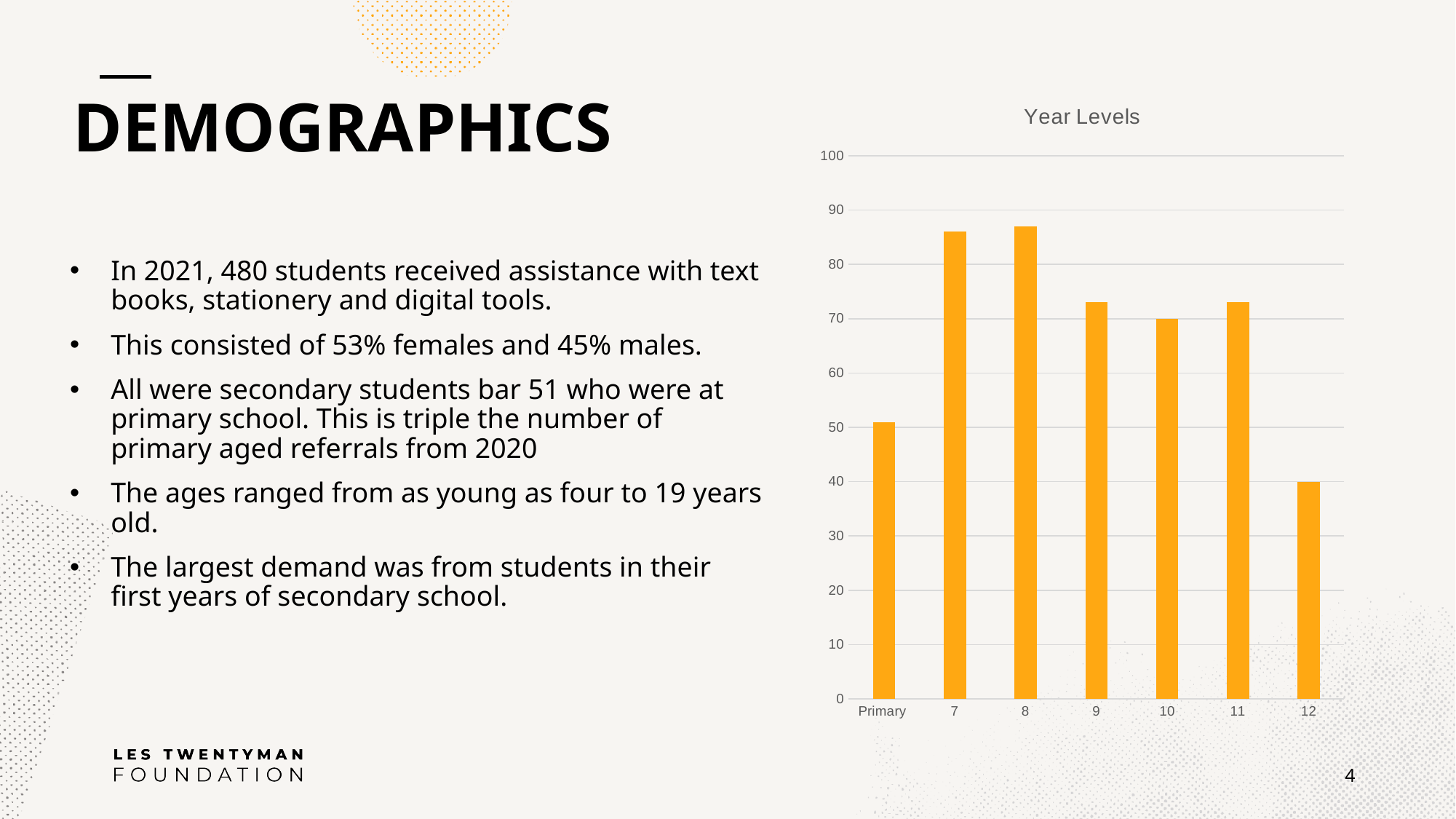
What kind of chart is shown on the slide? bar chart Is the value for year 12 greater or less than 50? less Which has the larger value, year 12 or Primary? Primary Is the value for year 8 greater or less than 80? greater Is the value for year 7 greater or less than 80? greater Which year level has the lowest bar in the chart? 12 What colour are the bars in the chart? orange Which has the larger value, year 7 or year 9? 7 What is the title of the chart? Year Levels How many categories are shown on the x axis of the chart? 7